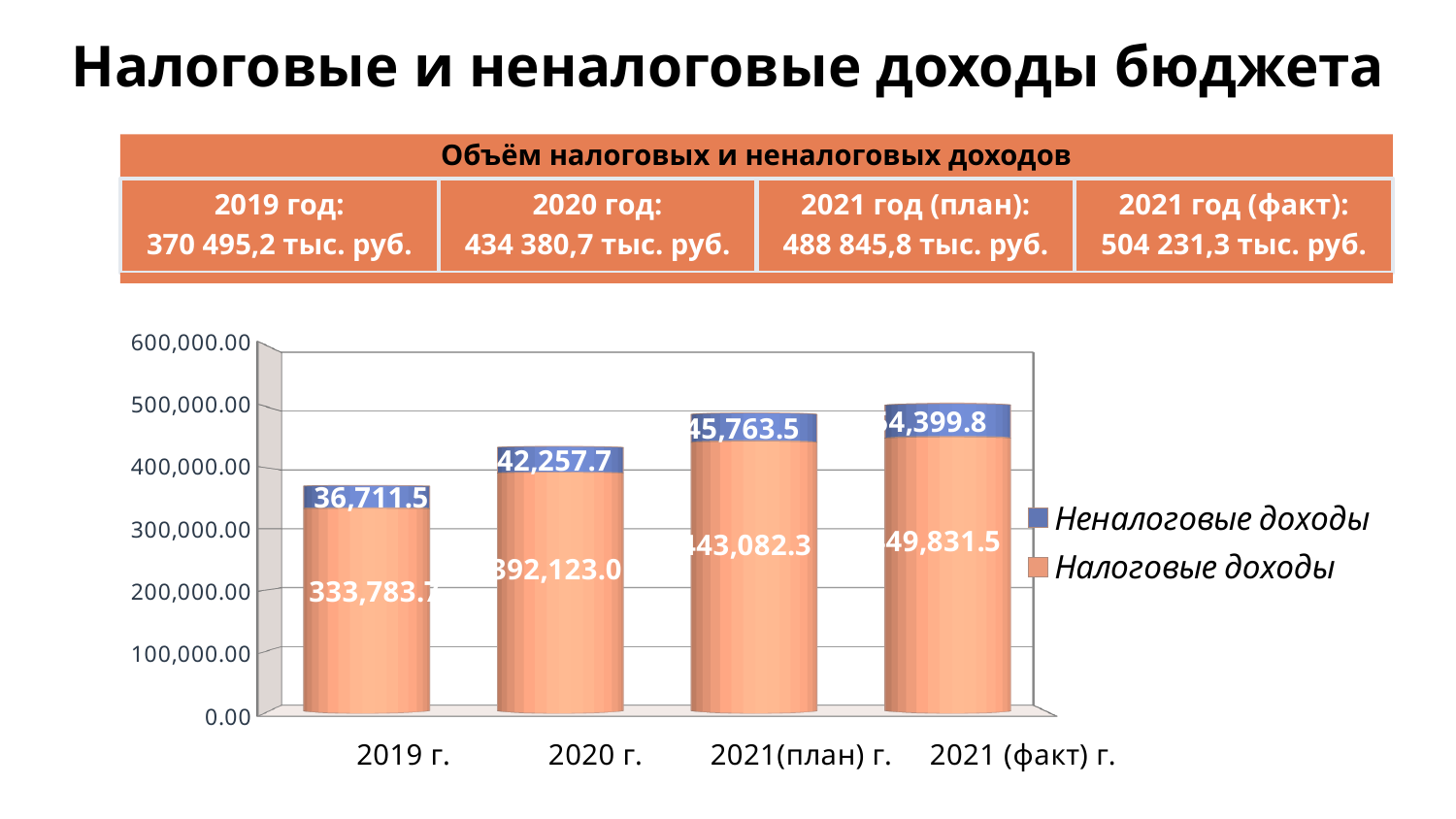
What is the value of Налоговые доходы for 2019 г.? 333,783.7 Do the Налоговые доходы values rise or fall from 2019 г. to 2021 (факт) г.? Rise Which category has the lowest value for Неналоговые доходы? 2019 г. How many series does the legend list? 2 What kind of chart is shown on the slide? Stacked bar chart What is the value of Неналоговые доходы for 2019 г.? 36,711.5 What is the value of Неналоговые доходы for 2020 г.? 42,257.7 What is the total of the stacked bar for 2019 г.? 370,495.2 Which colour represents Неналоговые доходы in the legend? Blue How many categories are shown on the x axis? 4 Is the total of the stacked bar for 2020 г. greater or less than 400,000.00? greater What is the value of Налоговые доходы for 2020 г.? 392,123.0